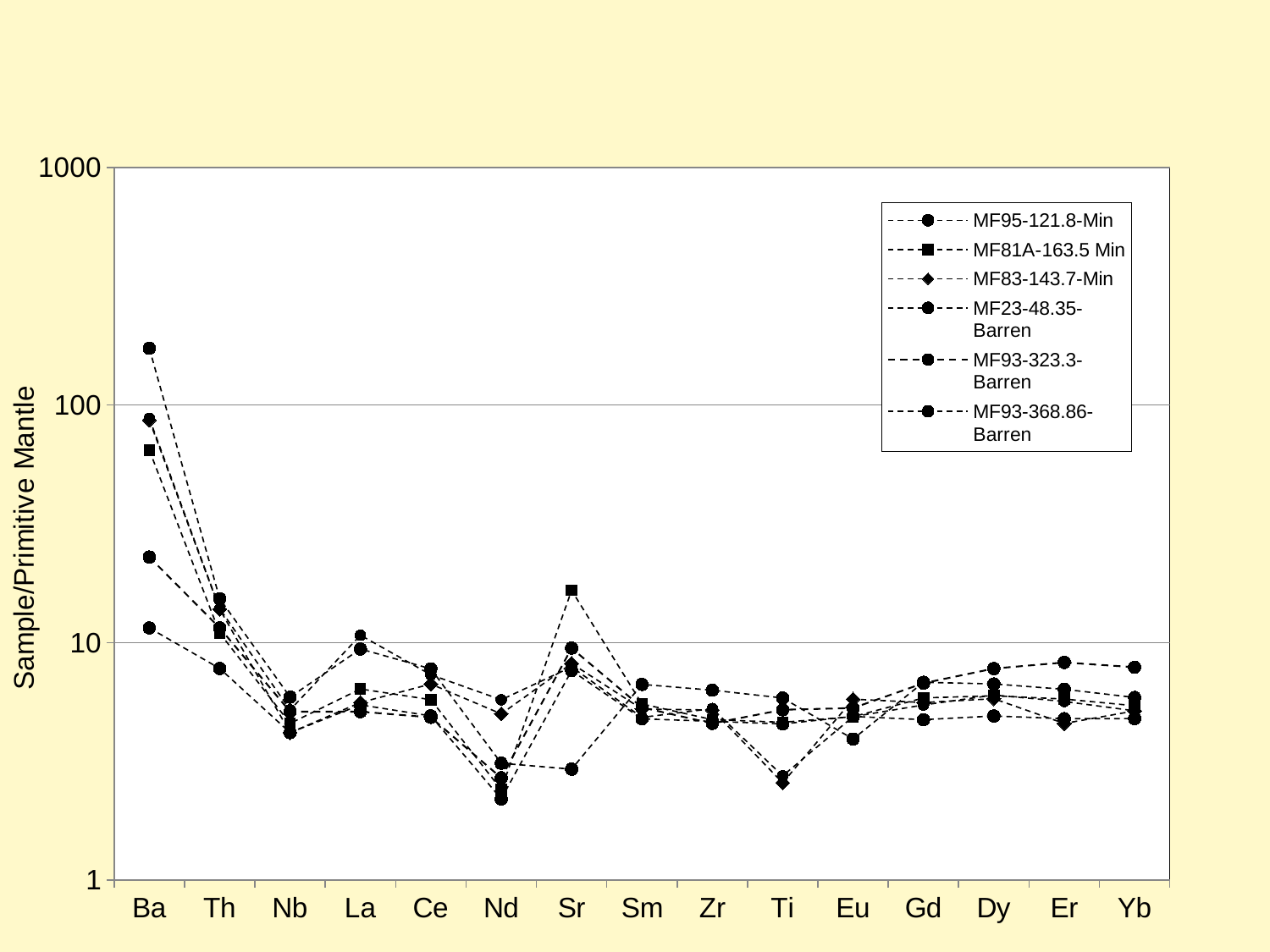
Is the value for MF81A-163.5 Min at Nd greater or less than 10? less Is the value for MF83-143.7-Min at Ti greater or less than 10? less At which category does the highest value on the chart occur? Ba What is the label of the y axis? Sample/Primitive Mantle Do the values for MF81A-163.5 Min rise or fall from Ba to Nb? fall Is the highest plotted value at Ba greater or less than 100? greater What kind of chart is shown on the slide? line chart How many series does the legend list? 6 How many categories are shown along the x axis? 15 Which series is listed first in the legend? MF95-121.8-Min